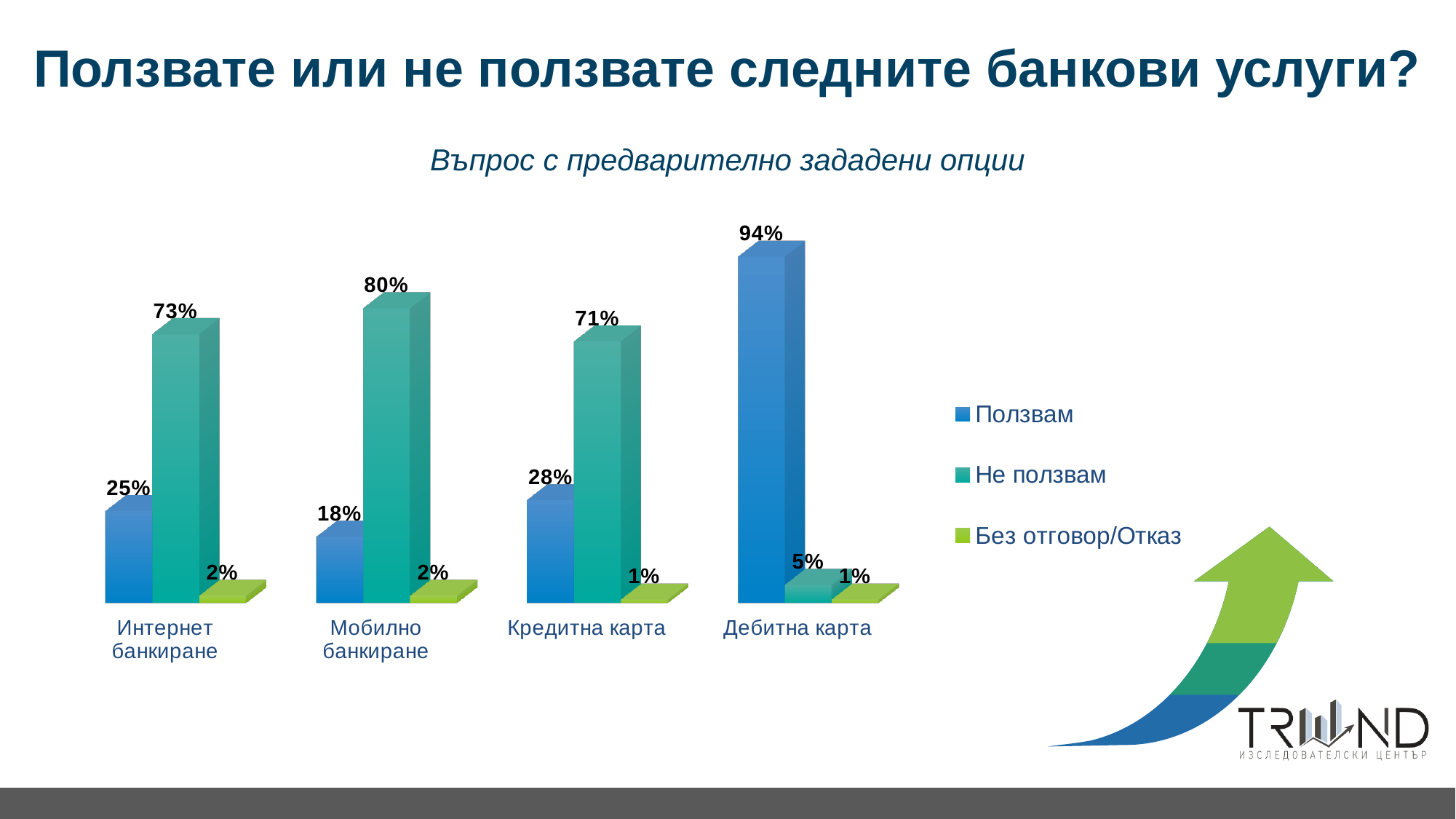
What percentage of respondents do not use (Не ползвам) mobile banking (Мобилно банкиране)? 80% Which category has the lowest 'Ползвам' value? Мобилно банкиране What percentage of respondents use (Ползвам) a debit card (Дебитна карта)? 94% Which category has the highest 'Ползвам' value? Дебитна карта What is the 'Без отговор/Отказ' value for Интернет банкиране? 2% How many series does the legend list? 3 What is the difference between the 'Не ползвам' and 'Ползвам' values for Кредитна карта? 43% Which is larger: the 'Ползвам' value for Интернет банкиране or for Кредитна карта? Кредитна карта What kind of chart is shown on the slide? Bar chart How many categories are shown on the x axis of the chart? 4 What is the 'Не ползвам' value for Дебитна карта? 5%